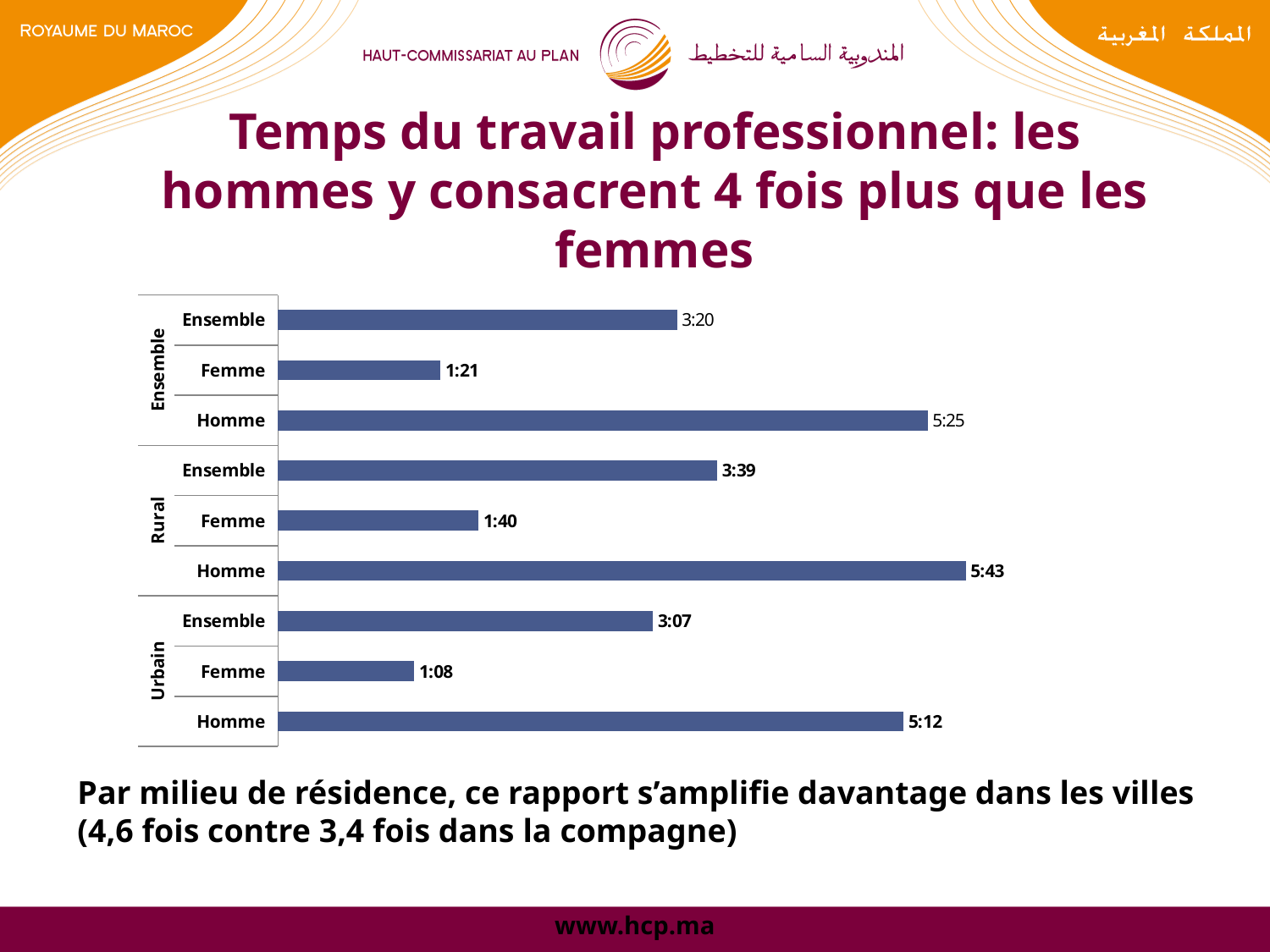
How many bars are plotted on the chart? 9 What is the value for Femme in the Rural group? 1:40 What are the three groups labelled on the vertical axis of the chart? Ensemble, Rural, Urbain What kind of chart is shown on the slide? Bar chart What is the value for Homme in the Urbain group? 5:12 What is the value for Homme in the Rural group? 5:43 Which bar has the highest value on the chart? Homme (Rural) What is the value for Femme in the Urbain group? 1:08 Which bar has the lowest value on the chart? Femme (Urbain) What is the value for Ensemble in the Ensemble group? 3:20 Which is larger: Ensemble in the Rural group or Ensemble in the Urbain group? Ensemble in the Rural group Which is larger: Homme in the Ensemble group or Homme in the Urbain group? Homme in the Ensemble group